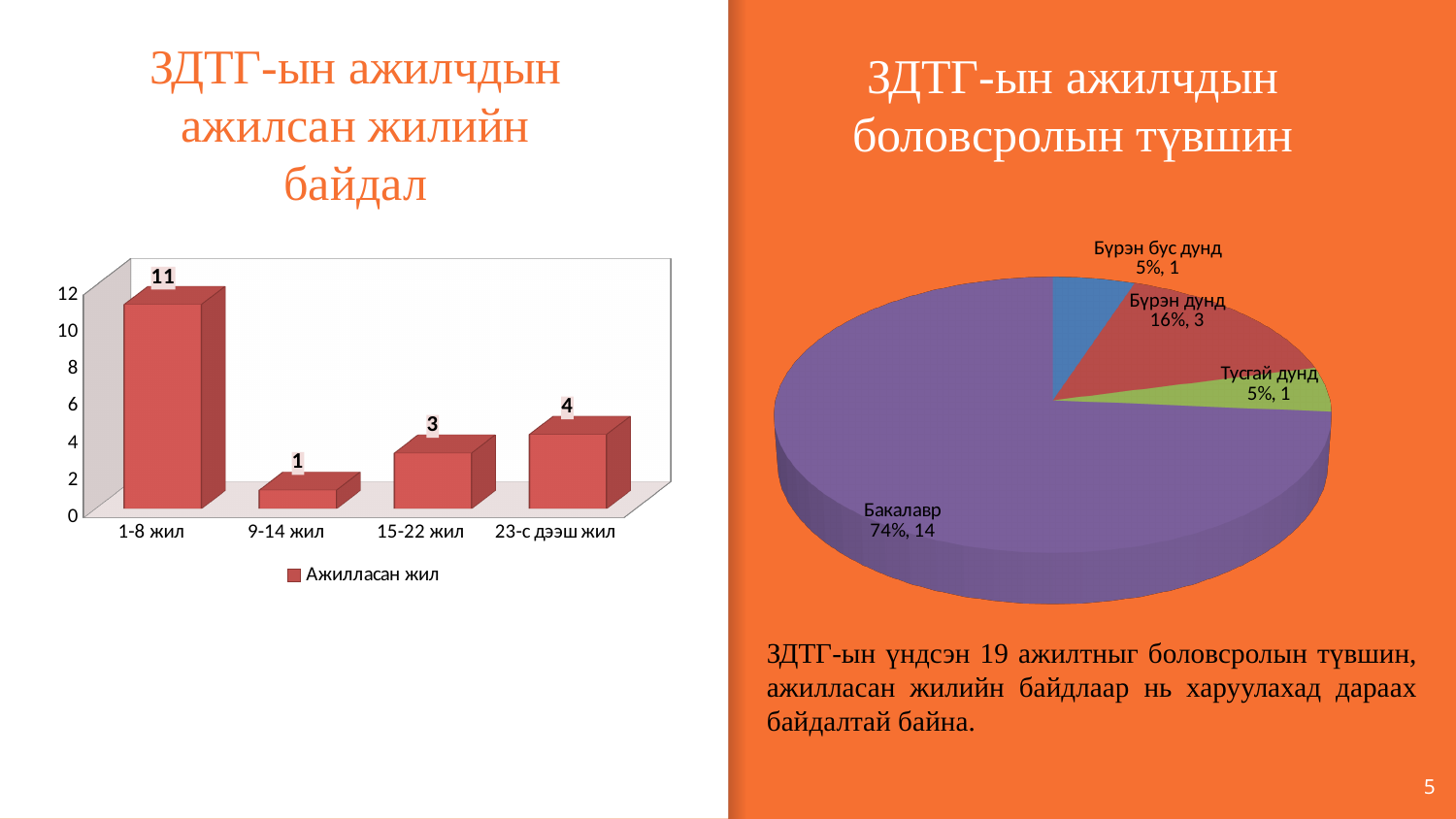
In the pie chart on the right, what is the count shown for Бүрэн дунд? 3 In the bar chart on the left, which category has the lowest value? 9-14 жил How many categories are shown in the bar chart on the left? 4 In the bar chart on the left, what is the value for 1-8 жил? 11 What kind of chart is on the left side of the slide? Bar chart In the pie chart on the right, which slice is the largest? Бакалавр In the pie chart on the right, what share does Бакалавр have? 74% In the bar chart on the left, what is the difference between the values for 1-8 жил and 23-с дээш жил? 7 What is the legend entry shown below the bar chart on the left? Ажилласан жил In the bar chart on the left, what is the value for 15-22 жил? 3 In the bar chart on the left, which category has the highest value? 1-8 жил In the bar chart on the left, which is larger: the value for 15-22 жил or the value for 23-с дээш жил? 23-с дээш жил